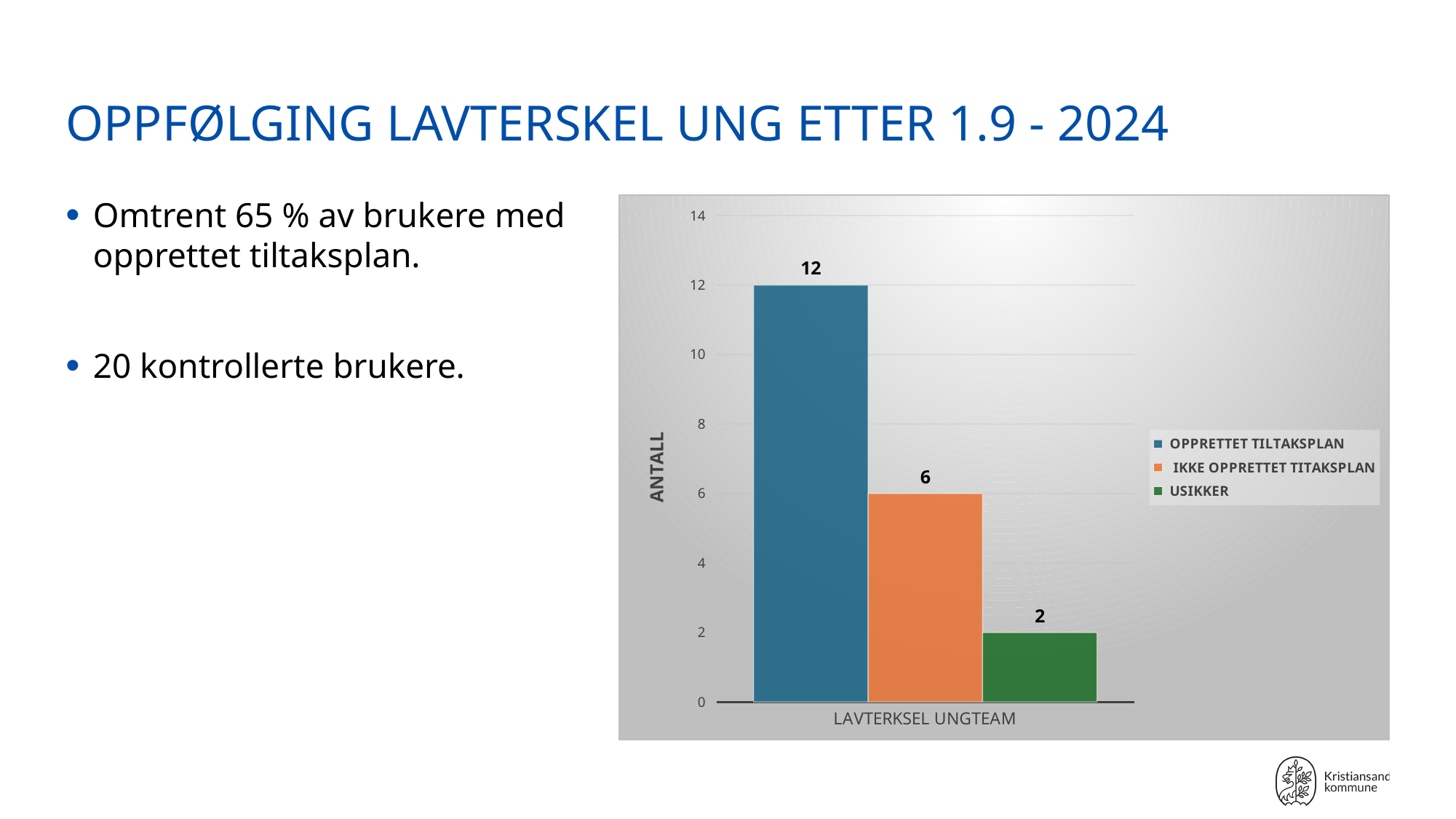
What is the value for OPPRETTET TILTAKSPLAN? 12 What is the category label on the horizontal axis? LAVTERKSEL UNGTEAM What kind of chart is shown on the slide? bar chart What is the difference between OPPRETTET TILTAKSPLAN and IKKE OPPRETTET TITAKSPLAN? 6 What is the label on the vertical axis? ANTALL Which series has the lowest value? USIKKER What is the value for IKKE OPPRETTET TITAKSPLAN? 6 Is the value for OPPRETTET TILTAKSPLAN greater or less than 10? greater Which series has the highest value? OPPRETTET TILTAKSPLAN How many series does the legend list? 3 Which is larger, IKKE OPPRETTET TITAKSPLAN or USIKKER? IKKE OPPRETTET TITAKSPLAN What is the value for USIKKER? 2